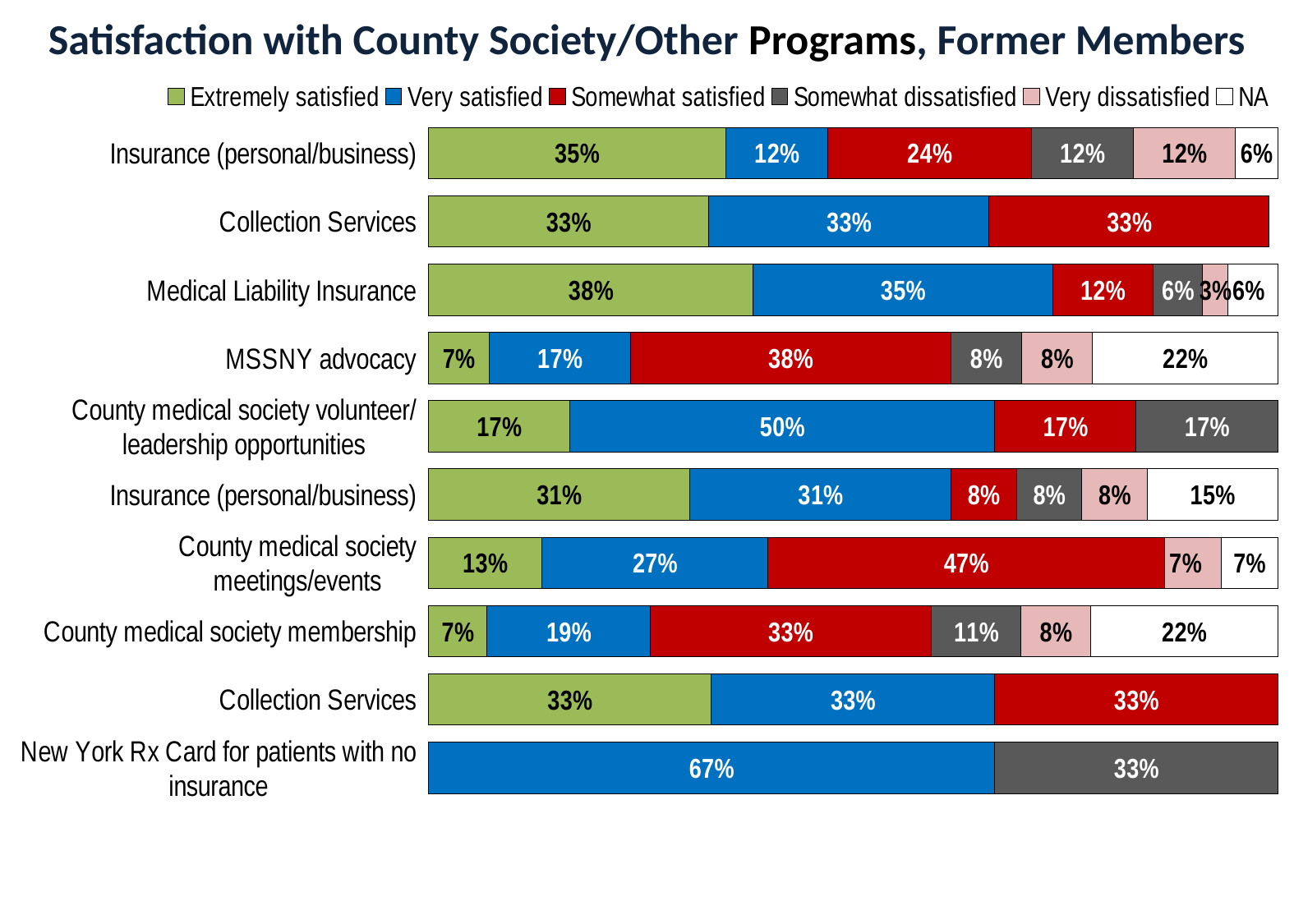
What is the Very satisfied value for New York Rx Card for patients with no insurance? 67% What percentage of former members were Very satisfied with County medical society volunteer/leadership opportunities? 50% Which has a larger Somewhat satisfied value, MSSNY advocacy or County medical society membership? MSSNY advocacy How many series does the legend list? 6 What is the Somewhat satisfied value for County medical society meetings/events? 47% What is the Extremely satisfied value for Medical Liability Insurance? 38% What is the NA value for MSSNY advocacy? 22% Which category has the highest Extremely satisfied value? Medical Liability Insurance For Medical Liability Insurance, what is the difference between the Extremely satisfied and Very satisfied values? 3 percentage points Which category has the highest Very satisfied value? New York Rx Card for patients with no insurance How many program categories are plotted in the chart? 10 What kind of chart is shown on the slide? Stacked bar chart